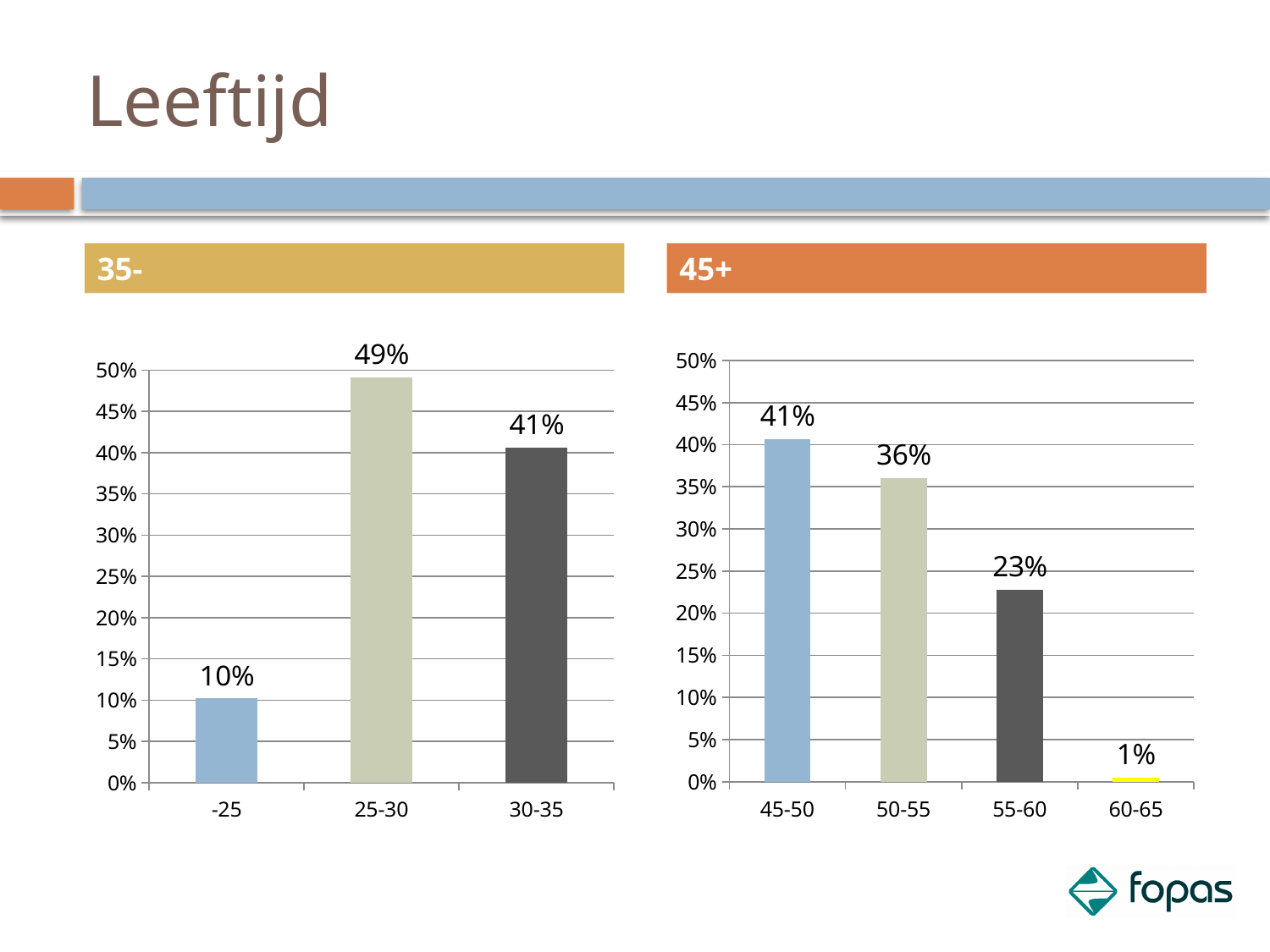
In the '35-' chart, which category has the highest value? 25-30 In the '35-' chart, what is the difference between the values for 25-30 and 30-35? 8% In the '45+' chart, do the values rise or fall from left to right along the x axis? fall How many categories are shown in the '45+' chart? 4 What kind of chart is the '35-' chart? bar chart In the '35-' chart, what is the value for the -25 category? 10% In the '35-' chart, what is the value for the 25-30 category? 49% In the '45+' chart, what is the value for the 55-60 category? 23% In the '45+' chart, what is the difference between the values for 45-50 and 50-55? 5% In the '45+' chart, which category has the lowest value? 60-65 In the '45+' chart, which is larger: the value for 50-55 or the value for 55-60? 50-55 In the '45+' chart, what is the value for the 60-65 category? 1%